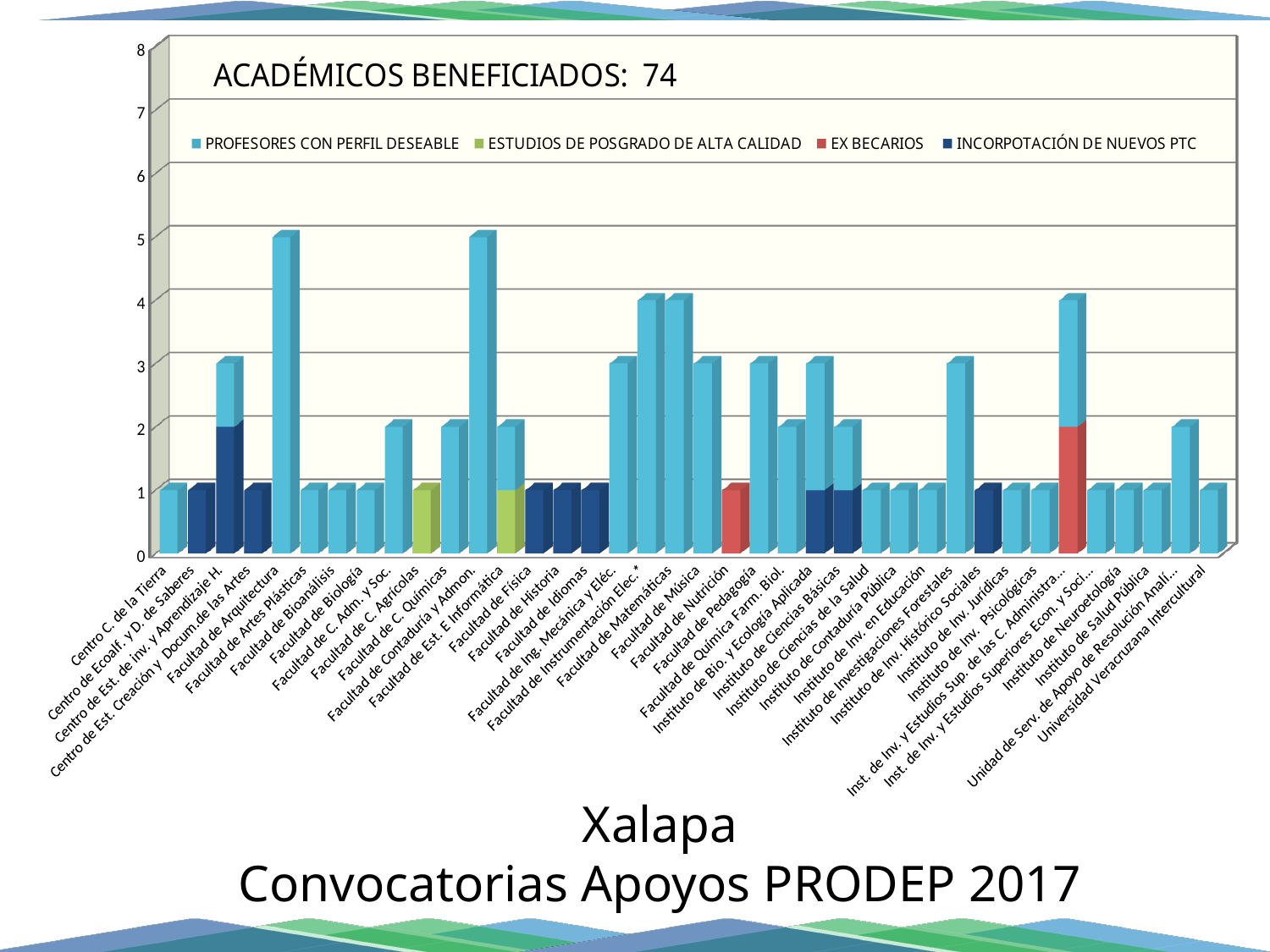
What is the difference between the bar for Facultad de Arquitectura and the bar for Facultad de Ing. Mecánica y Eléc.? 2 What kind of chart is shown on the slide? Stacked bar chart What is the value of the bar for Facultad de Música? 3 What number of beneficiaries is stated in the chart title? 74 Which is larger, the bar for Facultad de Arquitectura or the bar for Facultad de Pedagogía? Facultad de Arquitectura Which series is shown in red in the legend? EX BECARIOS What is the value of the bar for Facultad de Matemáticas? 4 Which is larger, the bar for Facultad de Instrumentación Elec. * or the bar for Facultad de Química Farm. Biol.? Facultad de Instrumentación Elec. * Is the value for Facultad de Contaduría y Admon. greater or less than 4? greater How many series does the legend list? 4 What is the total height of the stacked bar for Inst. de Inv. y Estudios Sup. de las C. Administra...? 4 What is the value of the bar for Facultad de Arquitectura? 5